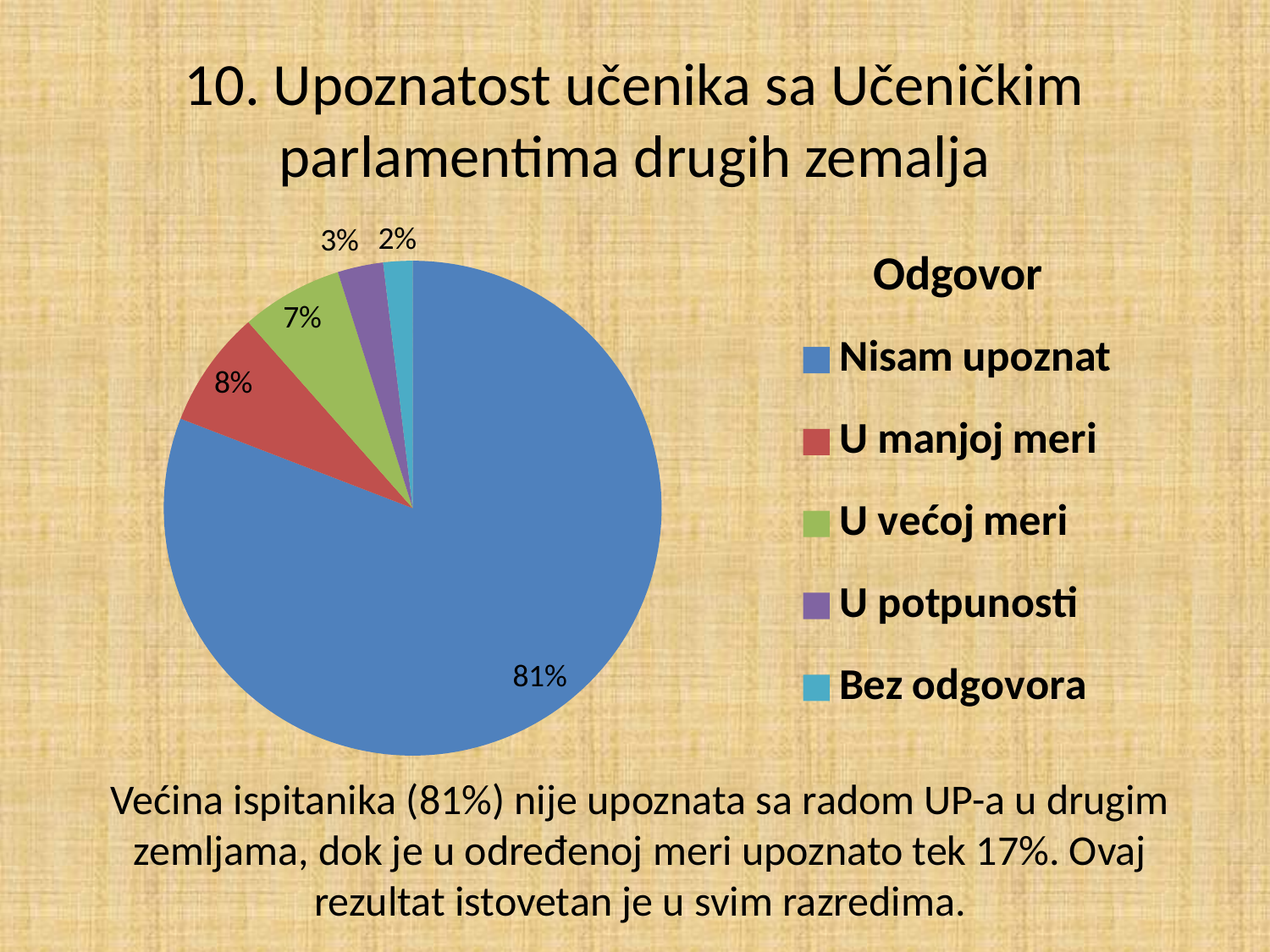
What percentage of the pie is labelled "Bez odgovora"? 2% Which slice is larger, "U manjoj meri" or "U većoj meri"? U manjoj meri Which category has the largest slice of the pie? Nisam upoznat What percentage of the pie is labelled "U većoj meri"? 7% What kind of chart is shown on the slide? pie chart What is the difference in percentage points between "Nisam upoznat" and "U manjoj meri"? 73 How many categories does the legend list? 5 Which category has the smallest slice of the pie? Bez odgovora What percentage of the pie is labelled "Nisam upoznat"? 81% What percentage of the pie is labelled "U potpunosti"? 3% What percentage of the pie is labelled "U manjoj meri"? 8% What is the title of the legend? Odgovor